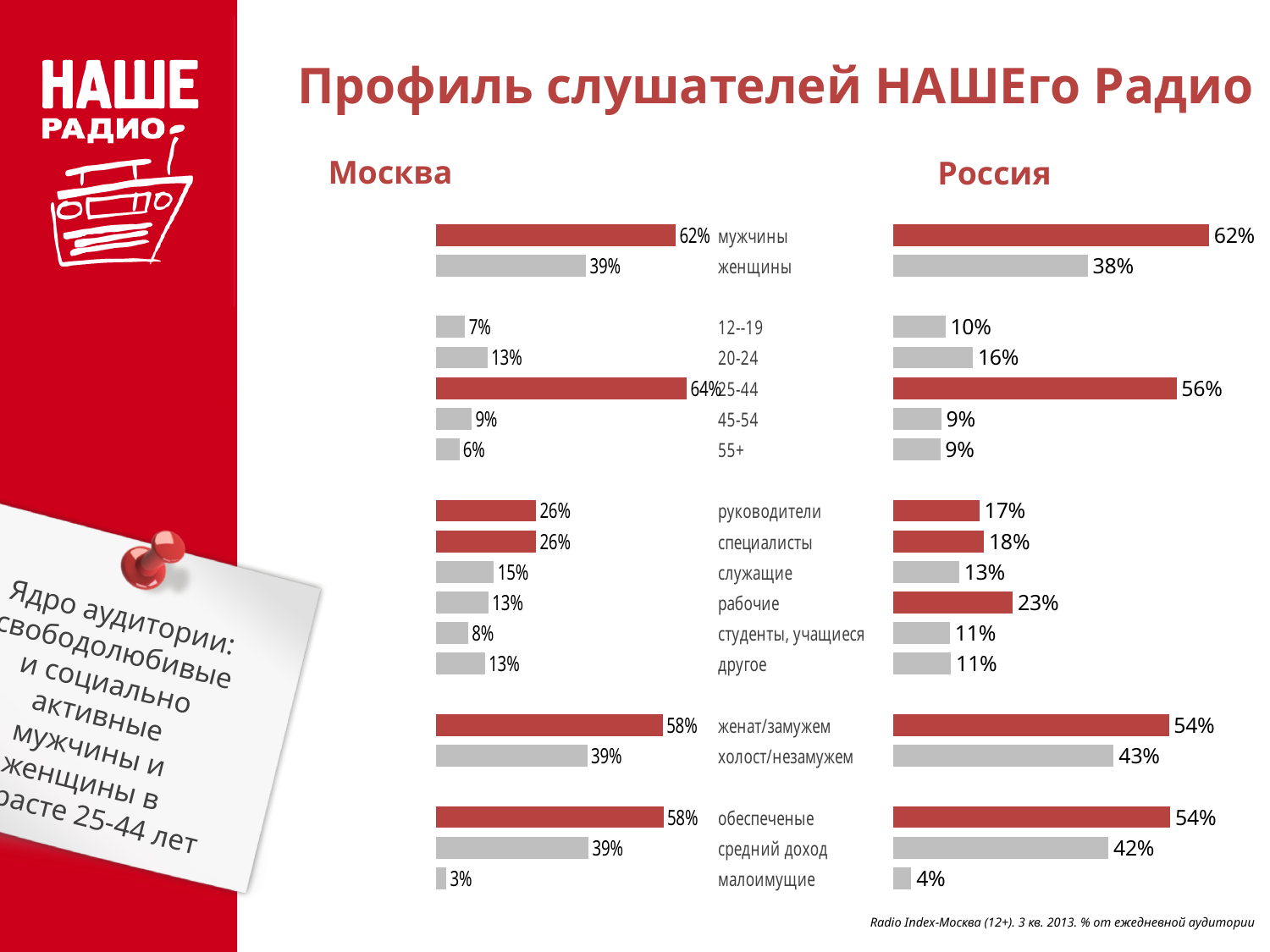
On the Россия chart, what is the value for женщины? 38% On the Москва chart, which category has the lowest value overall? малоимущие On the Москва chart, what is the value for мужчины? 62% On the Россия chart, what is the value for рабочие? 23% How many age groups are shown on the Москва chart? 5 On the Россия chart, what is the difference between женат/замужем and холост/незамужем? 11% Which is larger: the value for руководители on the Москва chart or on the Россия chart? Москва What is the difference between the 25-44 values on the Москва chart and the Россия chart? 8% What type of chart is used on this slide? Bar chart On the Россия chart, which occupation category has the highest value? рабочие On the Москва chart, which age group has the highest value? 25-44 On the Москва chart, what is the value for the 25-44 age group? 64%